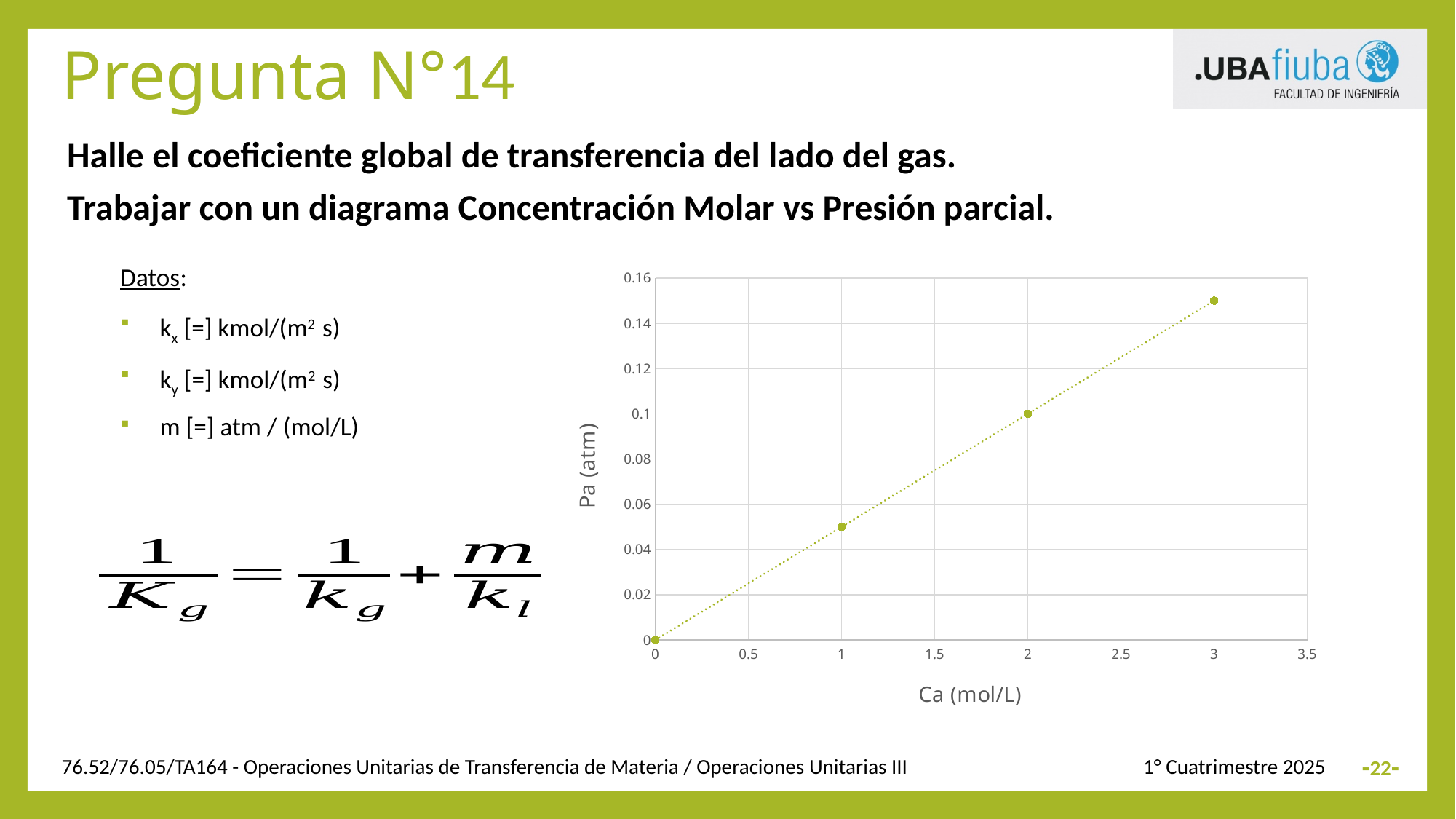
What is the value of Pa (atm) at Ca = 2 mol/L? 0.1 Is the value of Pa at Ca = 3 mol/L greater or less than 0.14? greater Which has a larger Pa value: Ca = 1 or Ca = 3? Ca = 3 What is the label of the x axis of the chart? Ca (mol/L) How many data points are plotted on the chart? 4 At which Ca value is Pa highest? 3 What is the value of Pa (atm) at Ca = 0 mol/L? 0 Is the value of Pa at Ca = 1 mol/L greater or less than 0.06? less Is the value of Pa at Ca = 1 mol/L greater or less than 0.04? greater What is the label of the y axis of the chart? Pa (atm) Do the Pa values rise or fall as Ca increases along the x axis? rise What kind of chart is shown on the slide? Scatter chart with a dotted line